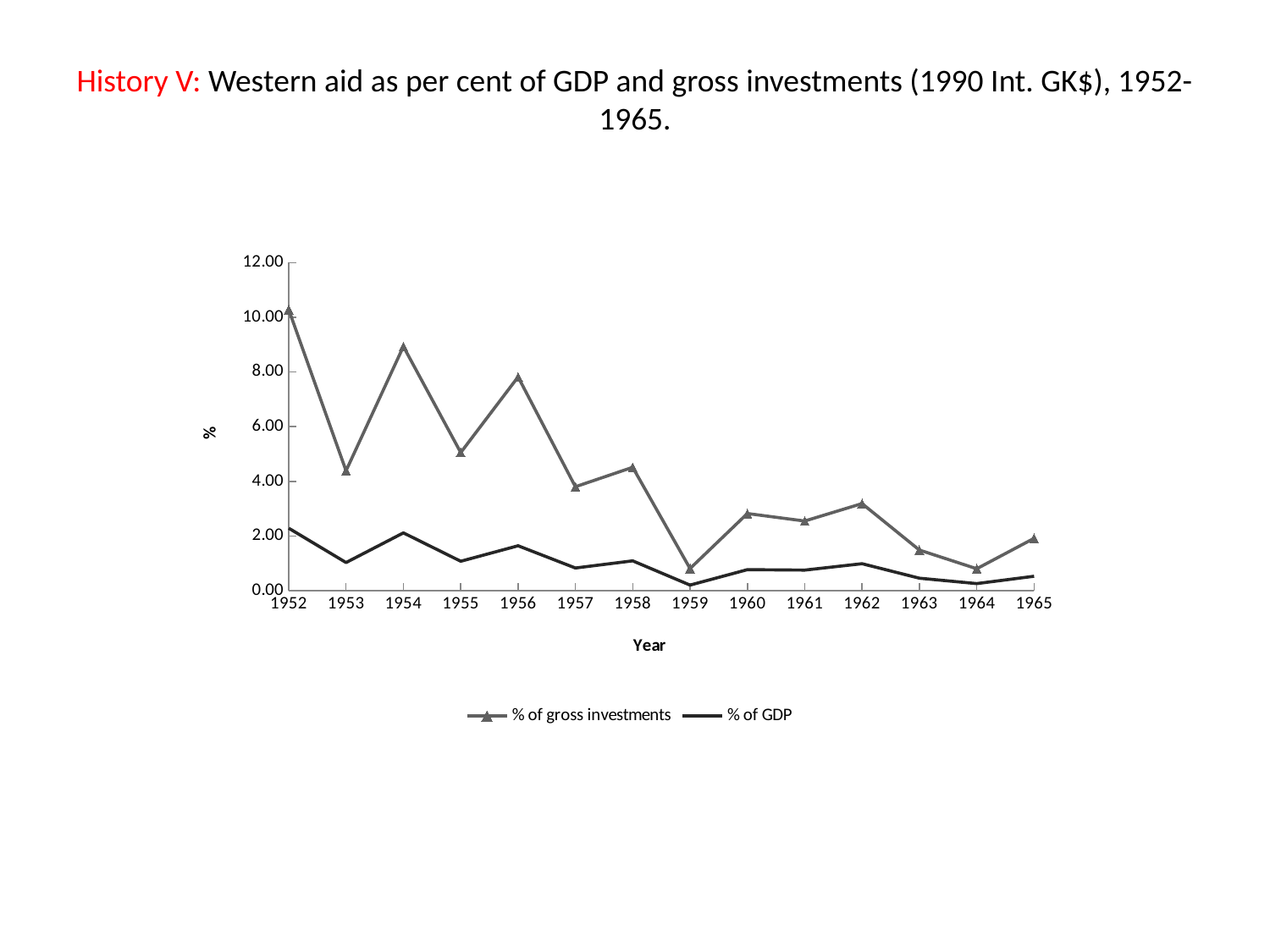
What kind of chart is shown on the slide? line chart In which year is the value for % of gross investments highest? 1952 Is the value for % of GDP in 1954 greater or less than 4.00? less In 1956, which series has the higher value, % of gross investments or % of GDP? % of gross investments Overall, does the % of gross investments series rise or fall from 1952 to 1965? fall What is the title of the x axis? Year How many series does the legend list? 2 Is the value for % of gross investments in 1959 greater or less than 2.00? less Is the value for % of gross investments in 1955 greater or less than 4.00? greater How many years are plotted along the x axis? 14 Which is larger, the % of gross investments value in 1952 or in 1953? 1952